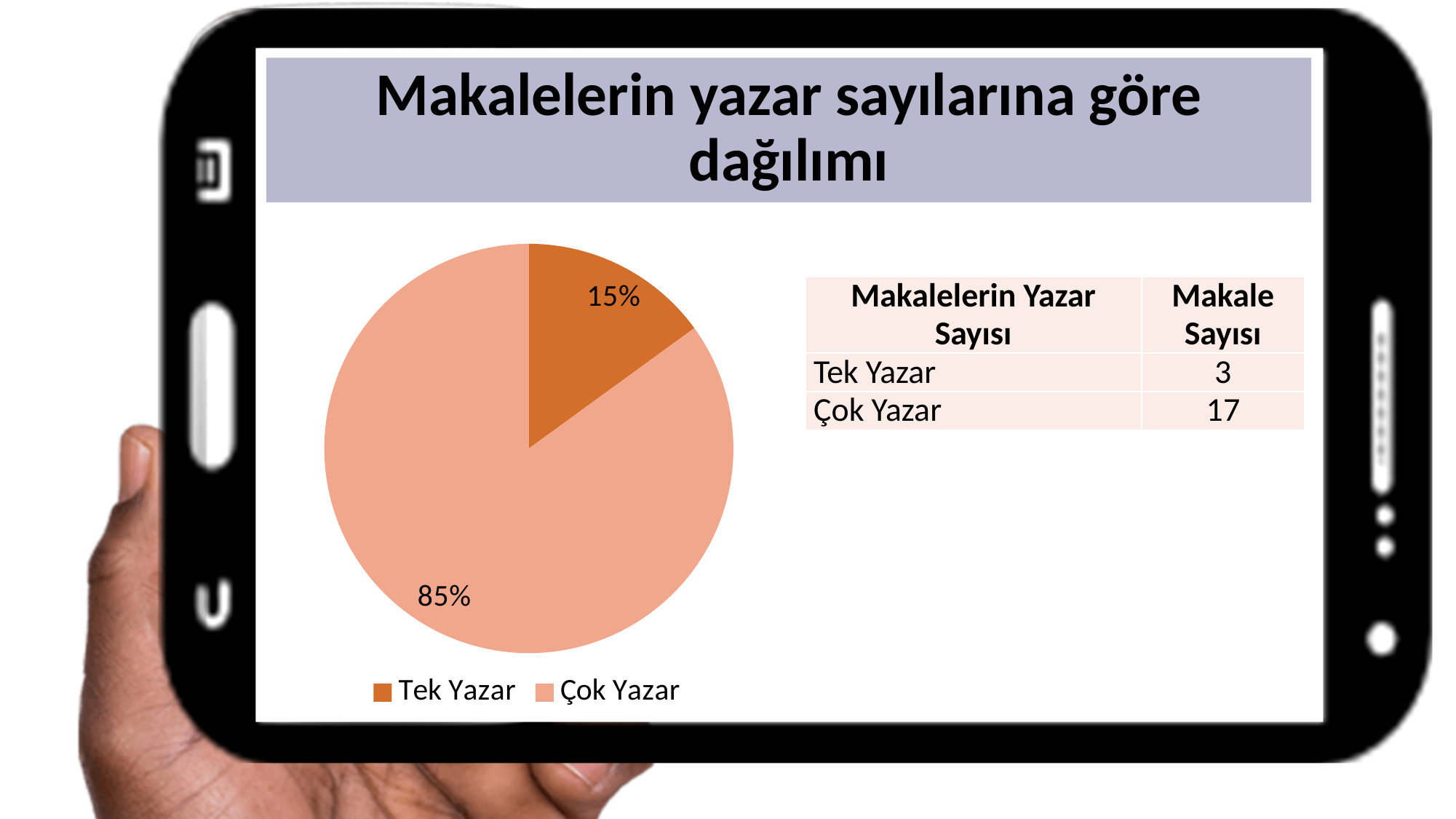
What is the title of the slide containing the pie chart? Makalelerin yazar sayılarına göre dağılımı Which category has the smallest slice in the pie chart? Tek Yazar How many entries does the legend of the pie chart list? 2 What kind of chart is shown on the slide? pie chart Which slice is larger, Tek Yazar or Çok Yazar? Çok Yazar What percentage of the pie chart does Tek Yazar represent? 15% What percentage of the pie chart does Çok Yazar represent? 85% Which legend entry is shown in the darker orange colour? Tek Yazar Is the share for Çok Yazar greater or less than 50%? greater Which category has the largest slice in the pie chart? Çok Yazar How many slices does the pie chart have? 2 What is the difference in percentage points between the Çok Yazar and Tek Yazar slices? 70